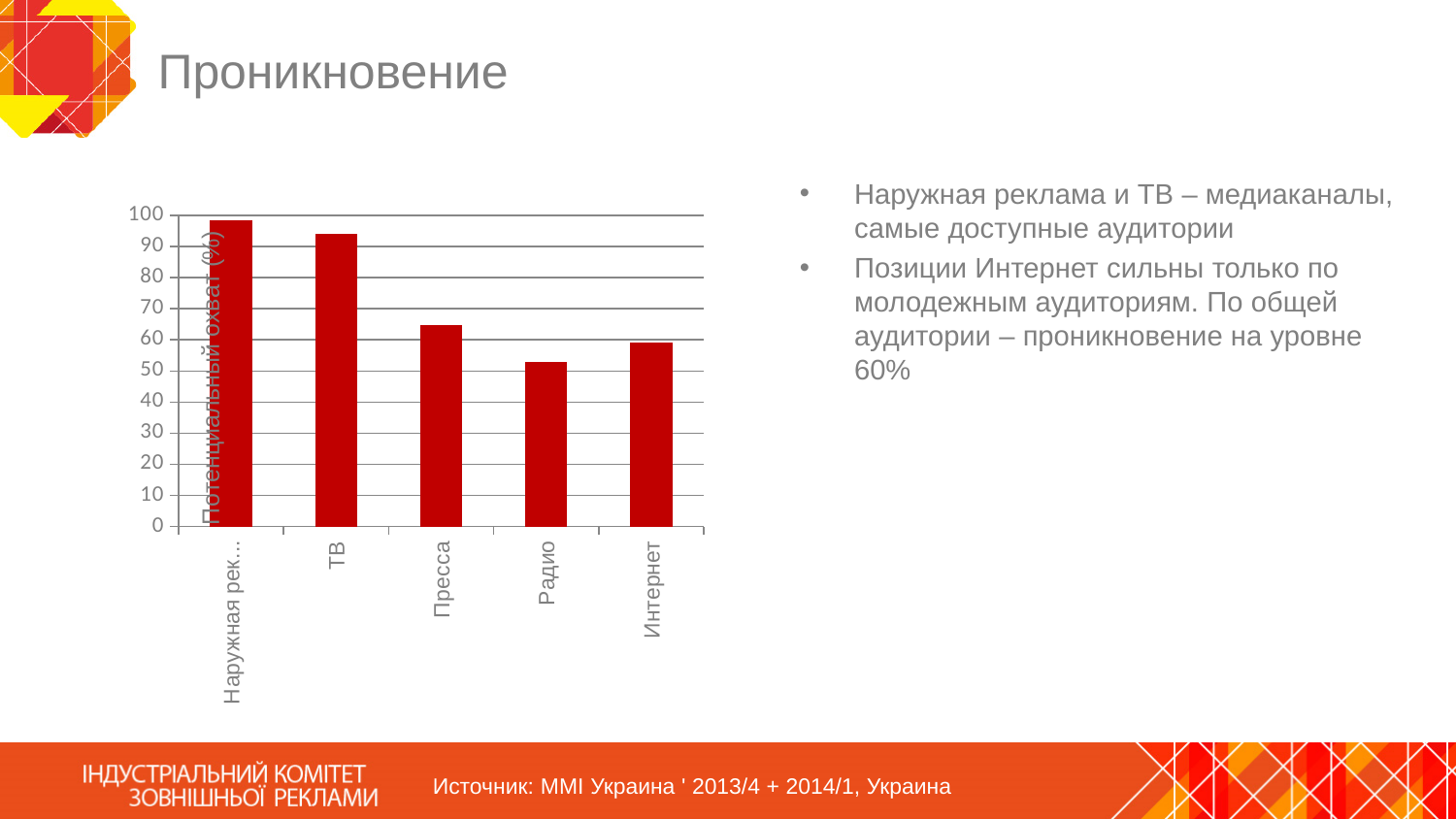
Which category has the lowest value in the chart? Радио Is the value for Радио greater or less than 60? less What is the title of the vertical axis of the chart? Потенциальный охват (%) What colour are the bars in the chart? red How many categories (bars) does the chart show? 5 What kind of chart is shown on the slide? bar chart Is the value for the leftmost bar (Наружная рек...) greater or less than 90? greater Which is larger, the value for Интернет or the value for Радио? Интернет Is the value for Интернет greater or less than 50? greater Which is larger, the value for ТВ or the value for Пресса? ТВ